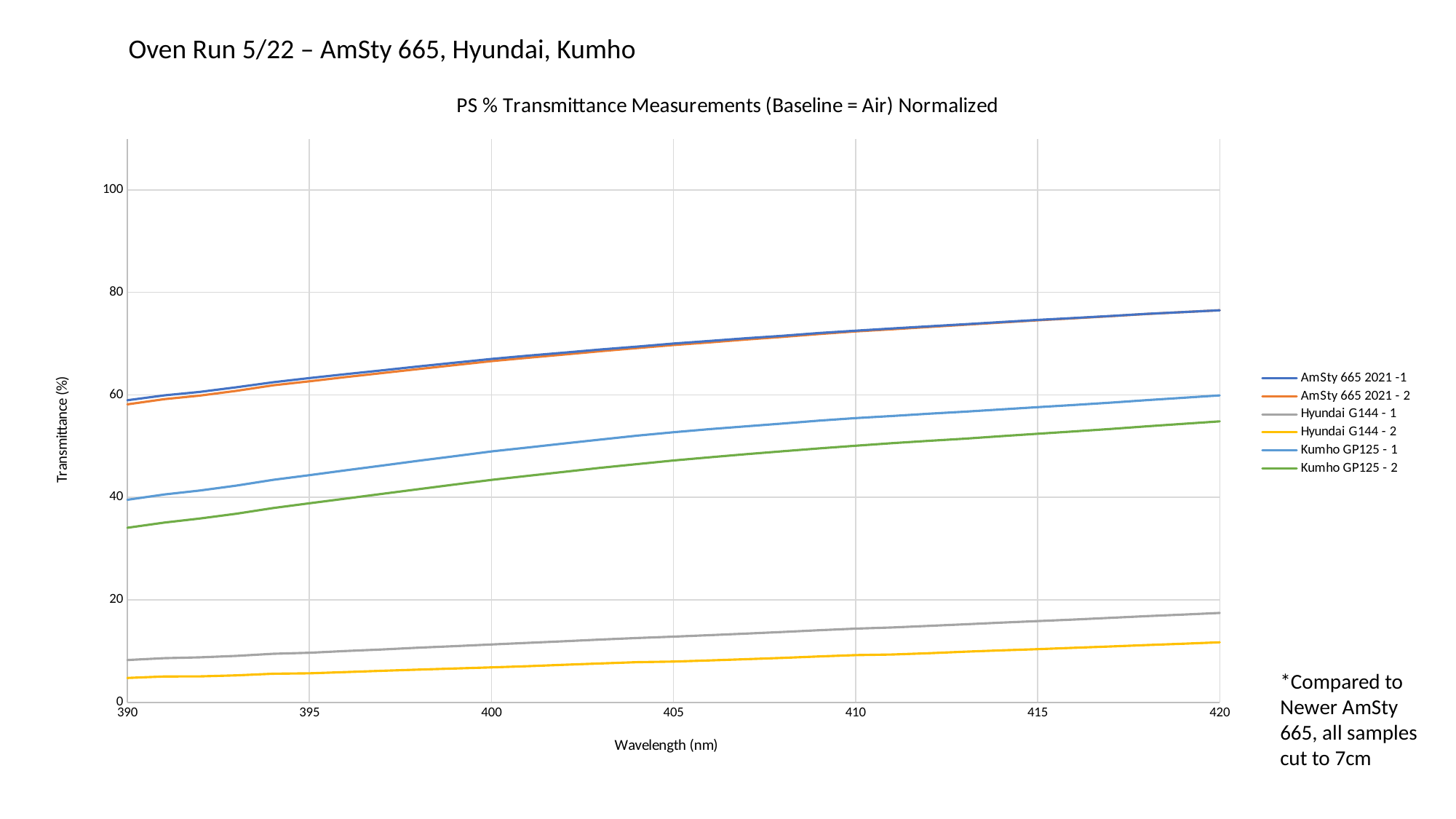
How many series does the legend list? 6 Which series has the lowest transmittance across the whole wavelength range? Hyundai G144 - 2 Is the value for AmSty 665 2021 -1 at 420 nm greater or less than 60? greater Is the value for Kumho GP125 - 2 at 420 nm greater or less than 40? greater What is the title of the chart? PS % Transmittance Measurements (Baseline = Air) Normalized Is the value for Hyundai G144 - 1 at 420 nm greater or less than 20? less Do the transmittance values for Kumho GP125 - 2 rise or fall as wavelength increases from 390 to 420 nm? rise What kind of chart is shown on the slide? line chart What is the label of the x axis? Wavelength (nm) At 410 nm, which series has the higher transmittance: Hyundai G144 - 1 or Hyundai G144 - 2? Hyundai G144 - 1 At 400 nm, which series has the higher transmittance: Kumho GP125 - 1 or Kumho GP125 - 2? Kumho GP125 - 1